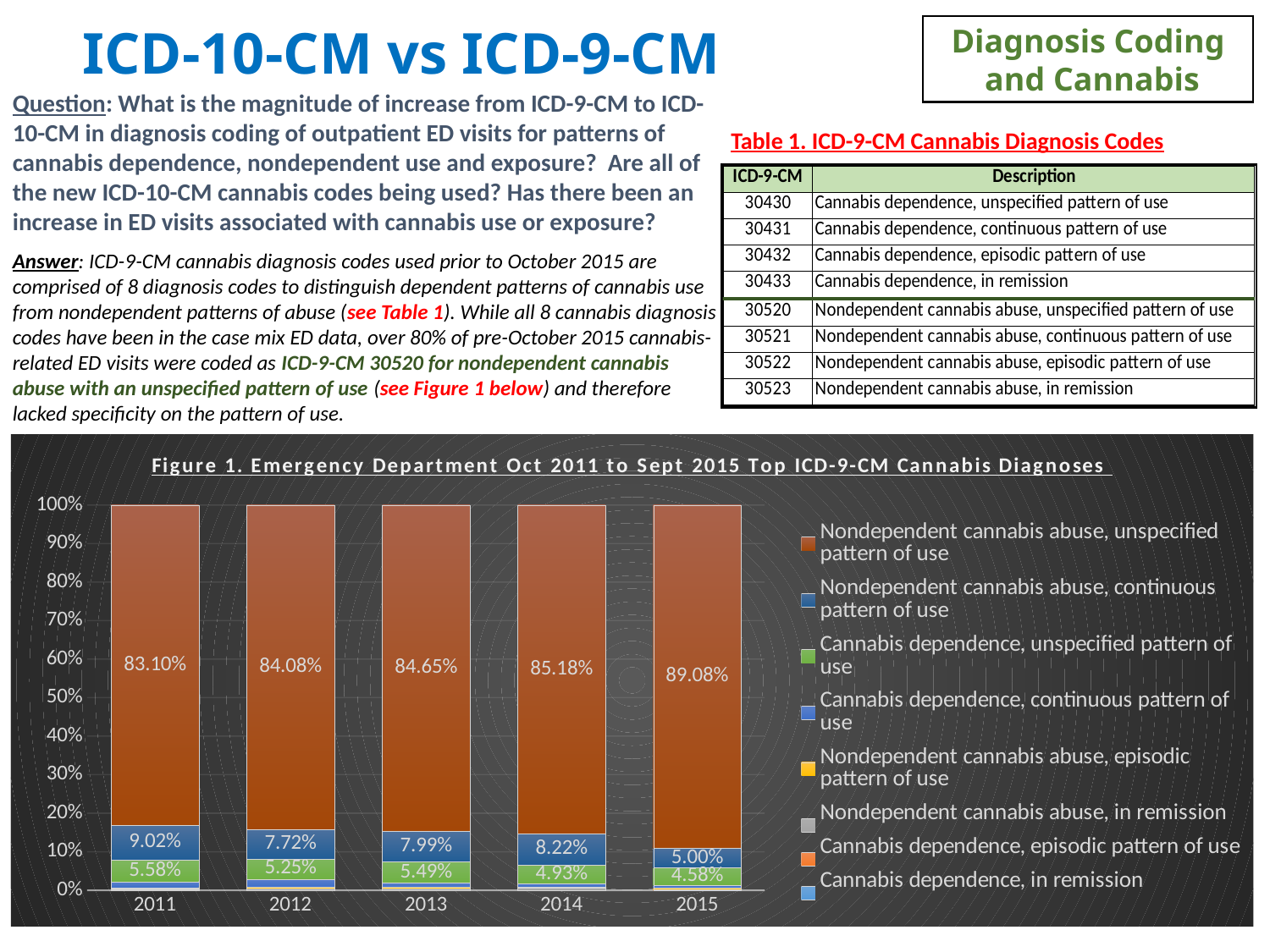
In Figure 1, what is the difference between the 2015 and 2011 values for nondependent cannabis abuse, unspecified pattern of use? 5.98% In Figure 1, which year has the lowest share for nondependent cannabis abuse, continuous pattern of use? 2015 In Figure 1, does the share for nondependent cannabis abuse, unspecified pattern of use rise or fall from 2011 to 2015? rise In Figure 1, which year has the highest share for nondependent cannabis abuse, unspecified pattern of use? 2015 In Figure 1, what percentage of ED visits in 2015 were coded as nondependent cannabis abuse, unspecified pattern of use? 89.08% In Figure 1, what is the value for cannabis dependence, unspecified pattern of use in 2013? 5.49% In Figure 1, what is the value for nondependent cannabis abuse, continuous pattern of use in 2011? 9.02% What kind of chart is Figure 1? stacked bar chart In Figure 1, is the value for nondependent cannabis abuse, unspecified pattern of use in 2014 greater or less than 80%? greater How many years are shown on the x axis of Figure 1? 5 In Figure 1, is the 2012 value for nondependent cannabis abuse, continuous pattern of use larger or smaller than the 2014 value? smaller How many series does the legend of Figure 1 list? 8